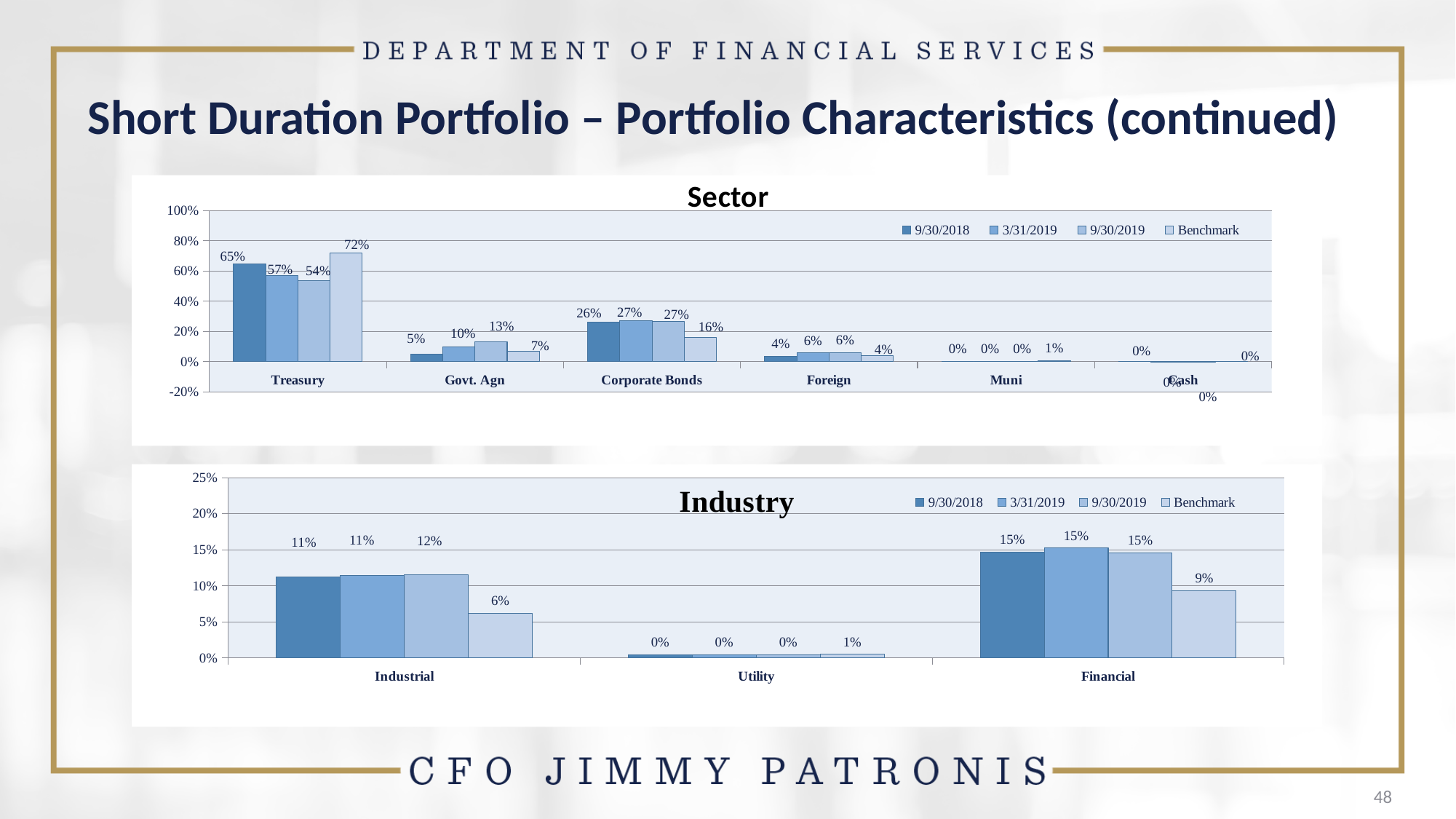
In the Industry chart, what is the 9/30/2019 value for Industrial? 12% How many series does the legend of the Sector chart list? 4 In the Sector chart, what is the 9/30/2019 value for Govt. Agn? 13% In the Industry chart, which category has the lowest Benchmark value? Utility In the Sector chart, which category has the highest 9/30/2018 value? Treasury In the Sector chart, what is the Benchmark value for Treasury? 72% How many categories are shown on the x axis of the Industry chart? 3 In the Sector chart, what is the difference between the 9/30/2018 and 9/30/2019 values for Treasury? 11% In the Industry chart, what is the Benchmark value for Financial? 9% In the Sector chart, what is the Benchmark value for Corporate Bonds? 16% In the Sector chart, is the 9/30/2018 value for Corporate Bonds greater or less than 20%? greater In the Industry chart, which is larger: the 3/31/2019 value for Industrial or the 3/31/2019 value for Financial? Financial